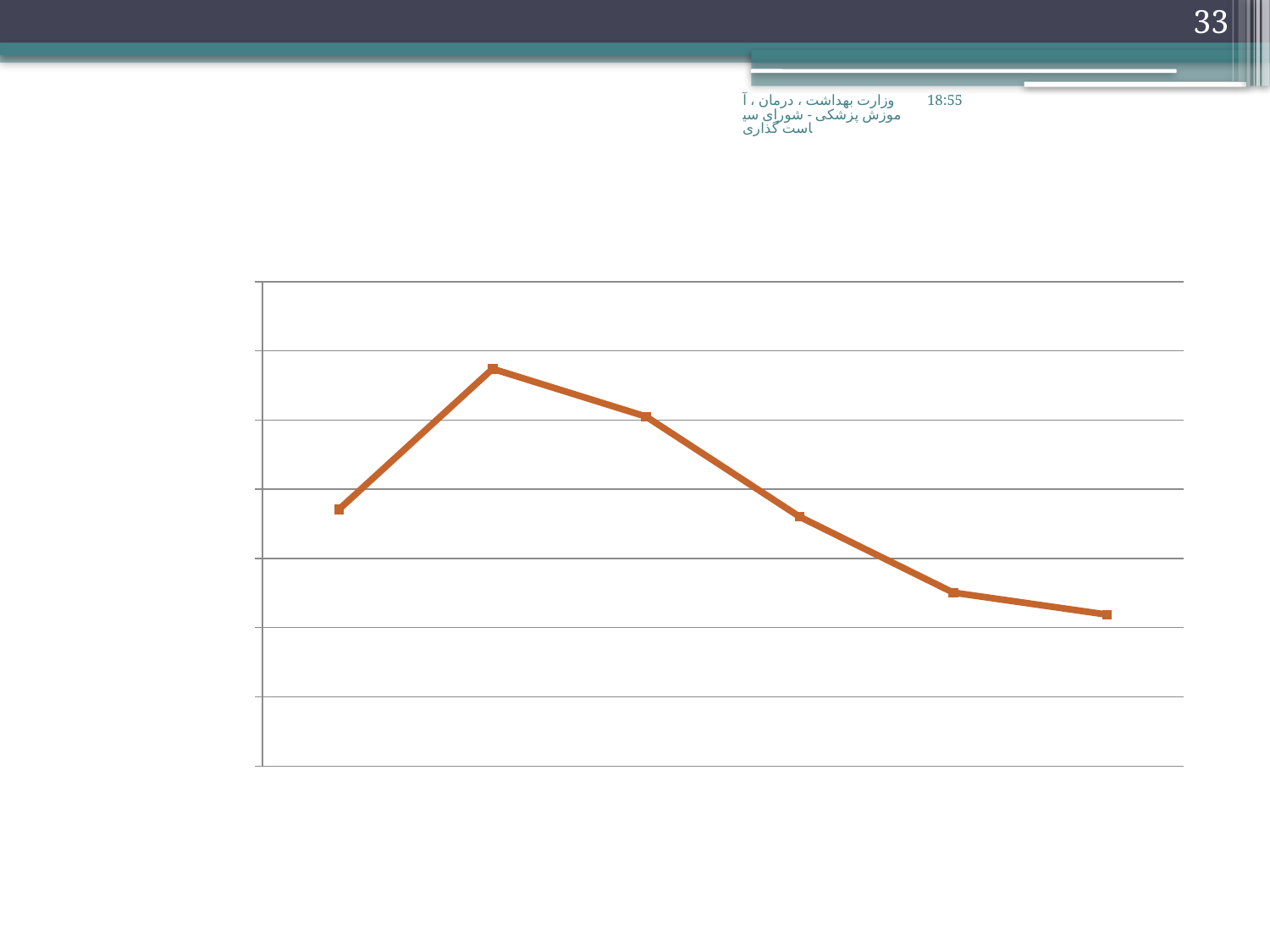
How many data points are plotted on the line? 6 Which is higher, the first point or the last point on the line? the first point How many lines (series) are plotted on the chart? 1 What kind of chart is shown on the slide? line chart Does the line rise or fall from the second point to the last point? fall Does the line rise or fall from the first point to the second point? rise Which data point on the line is the lowest, counting from the left? the last (sixth) point Which data point on the line is the highest, counting from the left? the second point Which is higher, the third point or the fourth point on the line? the third point What colour is the plotted line? orange